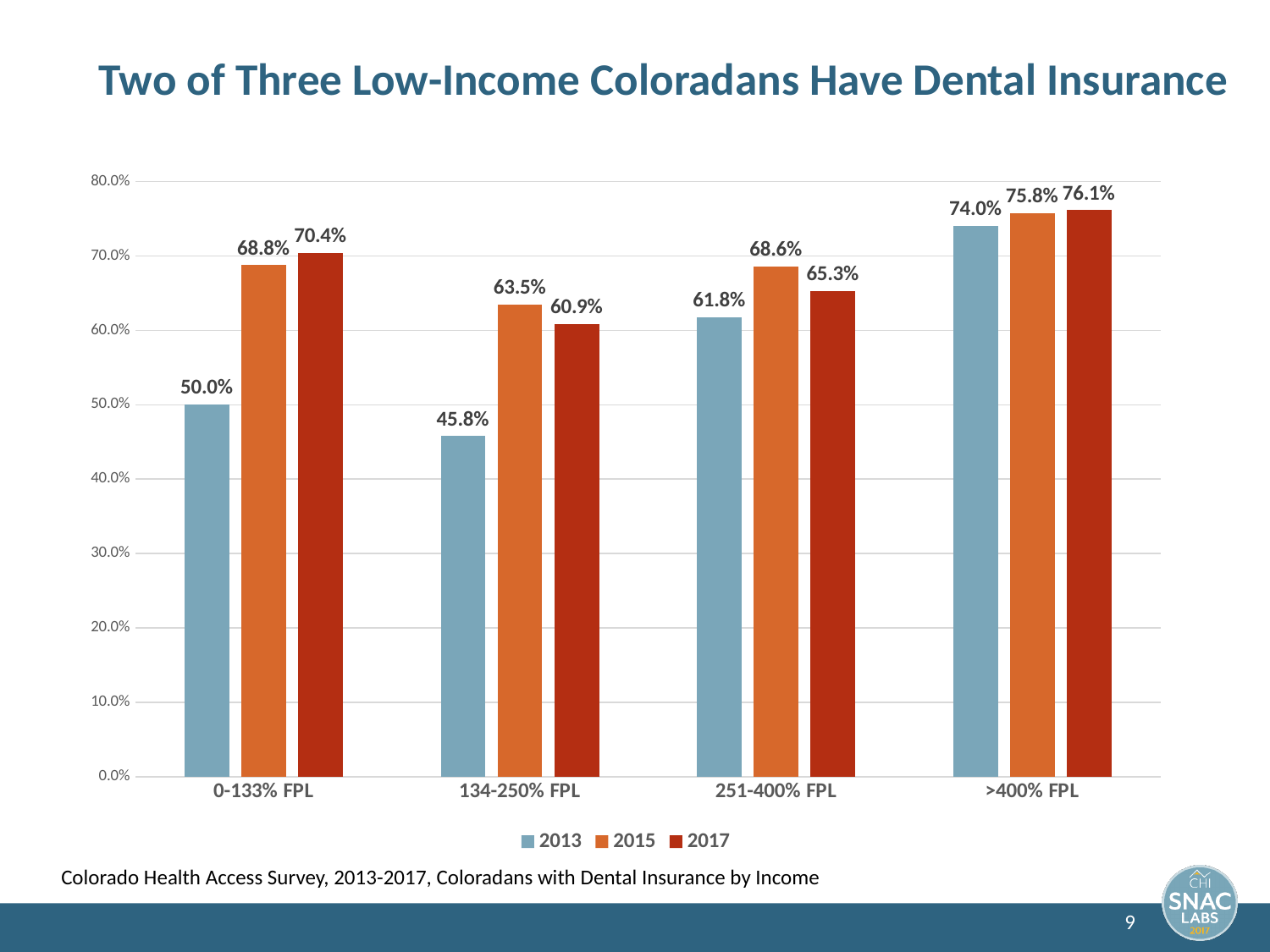
What is the title of the chart on the slide? Two of Three Low-Income Coloradans Have Dental Insurance Which income category has the lowest value for 2015? 134-250% FPL What is the value for 2017 in the 134-250% FPL category? 60.9% What is the value for 2015 in the 251-400% FPL category? 68.6% What kind of chart is shown on the slide? Bar chart What is the value for 2013 in the 0-133% FPL category? 50.0% How many series does the legend list? 3 Do the 2013 values rise or fall from 134-250% FPL to >400% FPL? Rise What is the difference between the 2017 and 2013 values in the 0-133% FPL category? 20.4% Which income category has the highest value for 2013? >400% FPL How many income categories are shown on the x axis? 4 Which is larger in the 251-400% FPL category: the 2015 value or the 2017 value? 2015